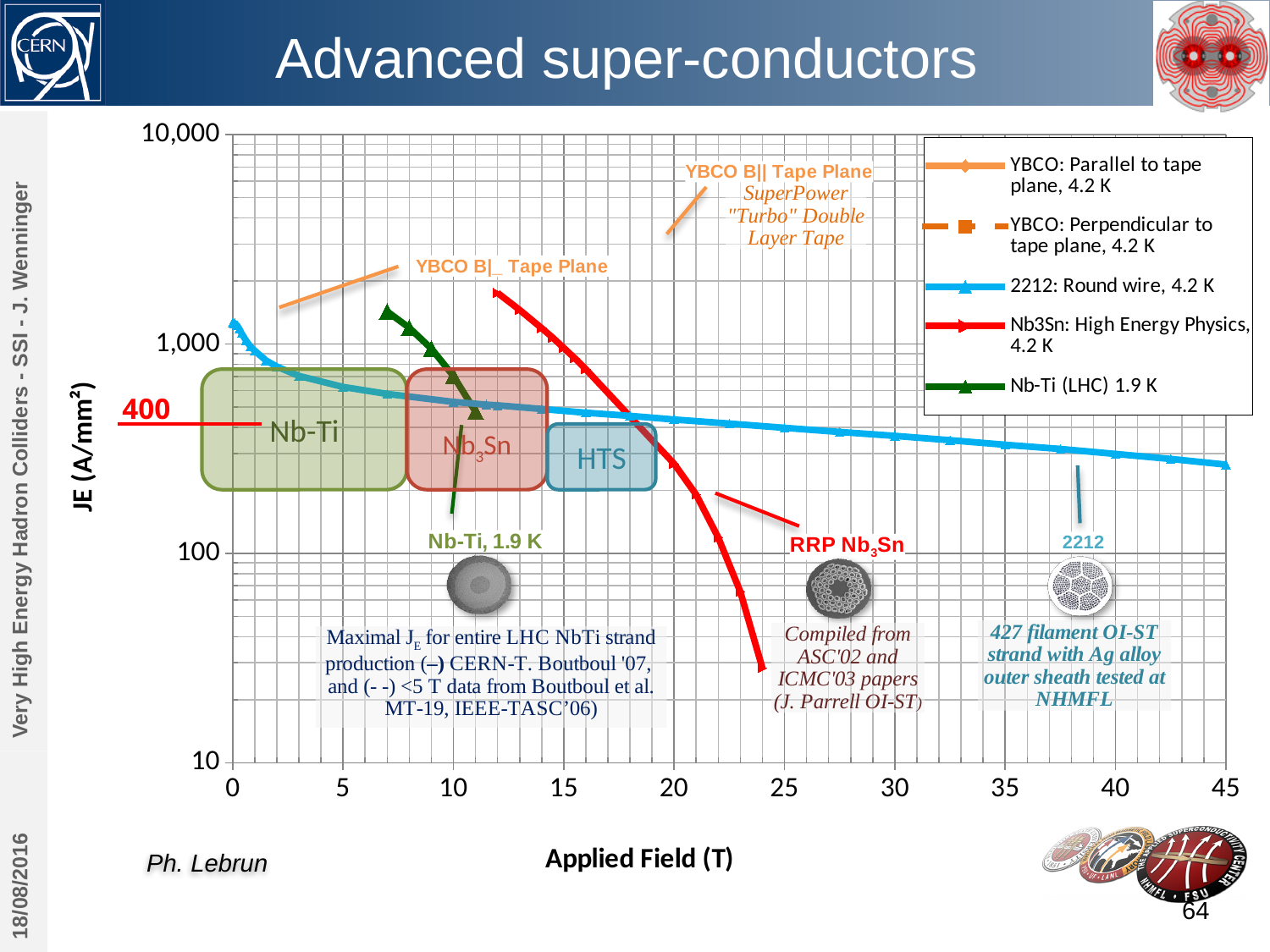
Is the value of the 2212: Round wire curve at 45 T greater or less than 400? less What temperature does the legend give for the Nb-Ti (LHC) series? 1.9 K How many series does the chart legend list? 5 What is the highest value shown on the x axis of the chart? 45 Does the Nb3Sn: High Energy Physics curve rise or fall as the applied field increases? fall What kind of chart is shown on the slide? line chart What is the title of the x axis of the chart? Applied Field (T) Which series extends to the highest applied field on the chart? 2212: Round wire, 4.2 K What value is marked in red on the y axis of the chart? 400 Is the value of the Nb3Sn: High Energy Physics curve at 24 T greater or less than 100? less Is the value of the 2212: Round wire curve at 0 T greater or less than 1,000? greater